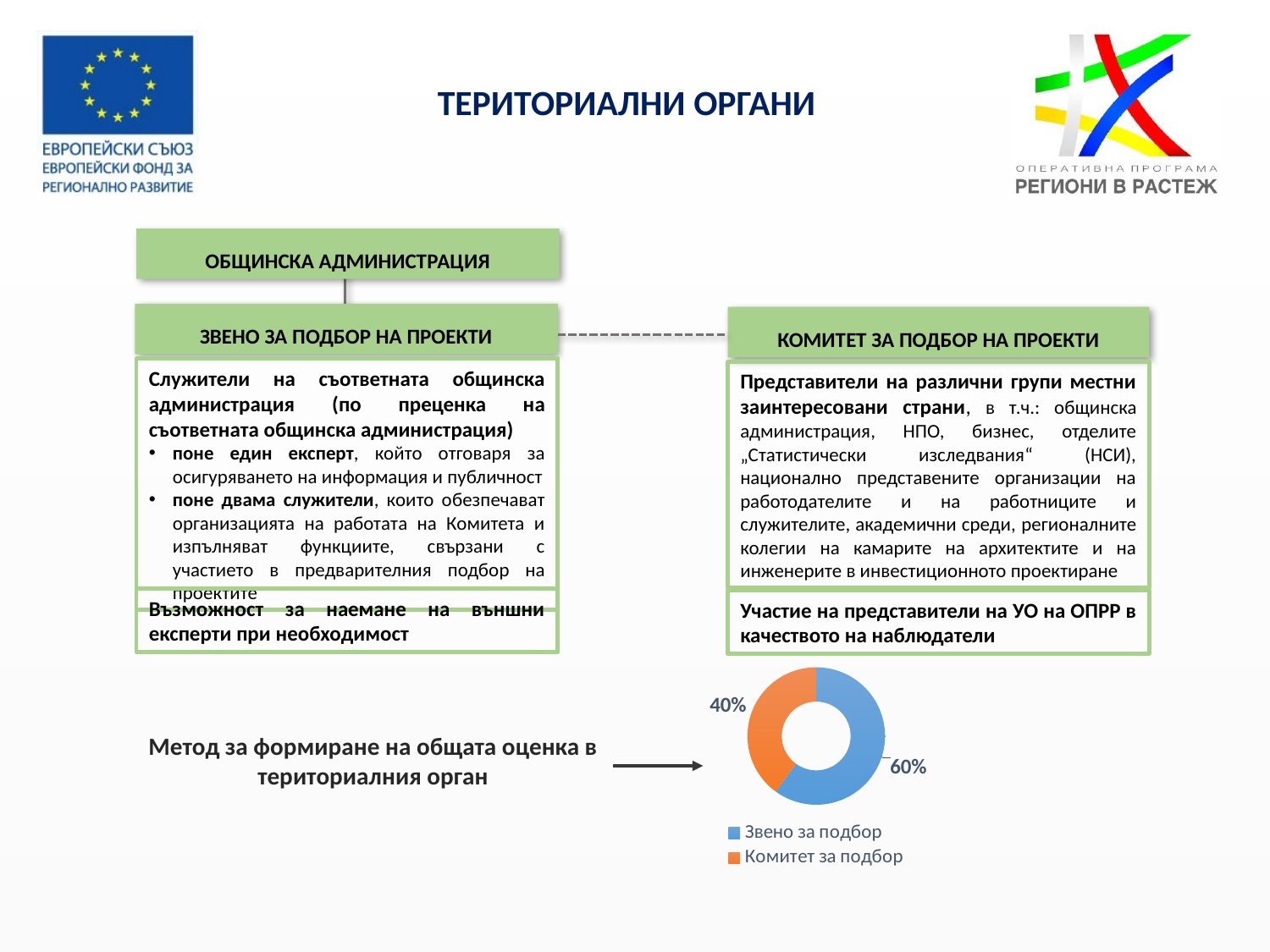
What share does "Комитет за подбор" have in the donut chart? 40% Which is larger in the donut chart: "Звено за подбор" or "Комитет за подбор"? Звено за подбор Which slice of the donut chart is the largest? Звено за подбор What colour is the "Звено за подбор" slice in the donut chart? Blue What kind of chart is shown at the bottom of the slide? Donut (pie) chart What is the total of the two slices shown in the donut chart? 100% Which slice of the donut chart is the smallest? Комитет за подбор What colour is the "Комитет за подбор" slice in the donut chart? Orange How many slices does the donut chart have? 2 What share does "Звено за подбор" have in the donut chart? 60% How many entries does the legend of the donut chart list? 2 What is the difference in percentage points between the "Звено за подбор" and "Комитет за подбор" slices? 20 percentage points